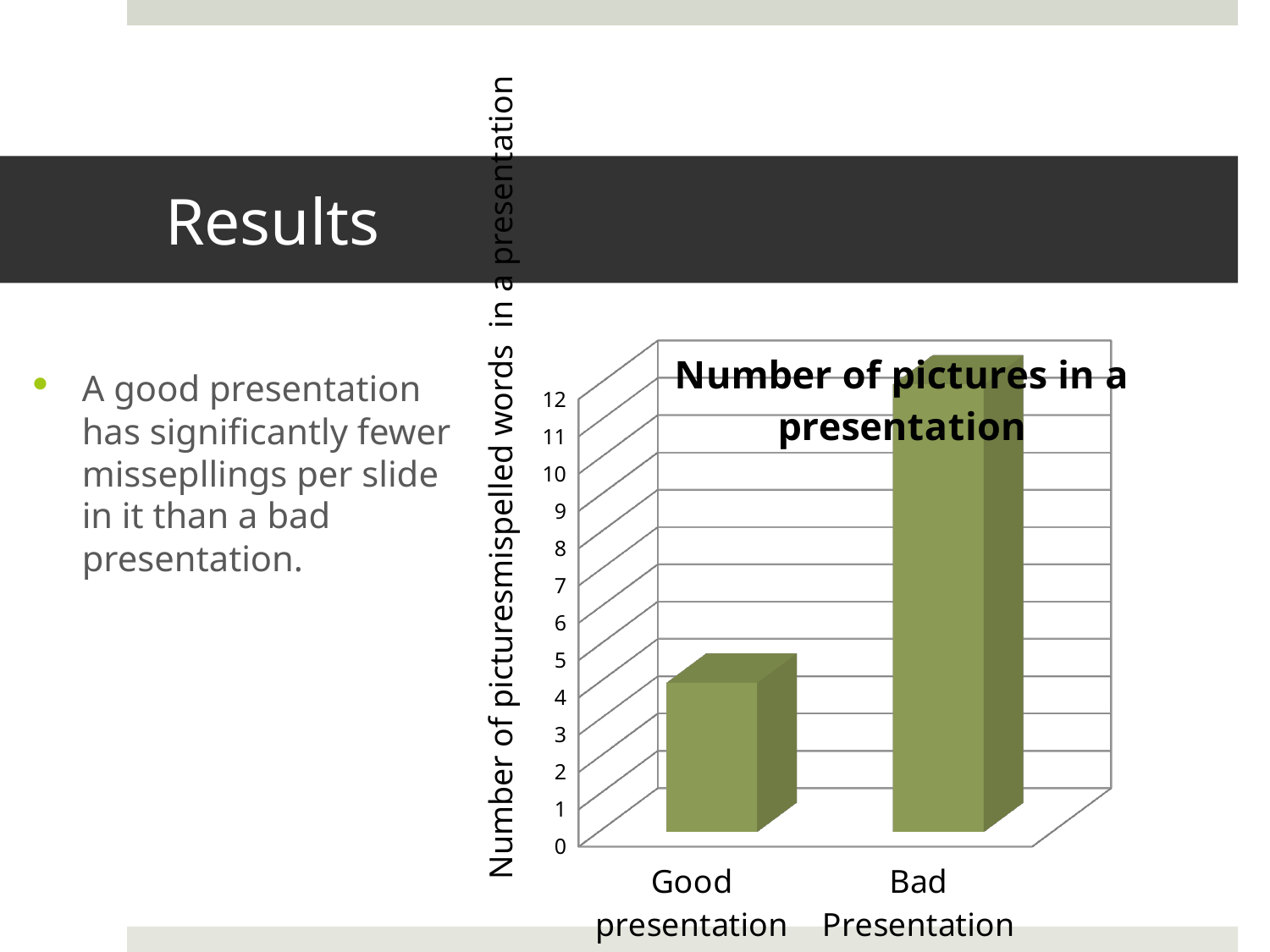
How many categories are plotted in the chart? 2 Is the value for Good presentation greater or less than 2? greater What are the two category labels on the x axis of the chart? Good presentation, Bad Presentation Is the value for Bad Presentation greater or less than 10? greater Which is larger, the value for Good presentation or the value for Bad Presentation? Bad Presentation Which category has the lowest bar? Good presentation What kind of chart is shown on the slide? bar chart What is the title of the chart? Number of pictures in a presentation Is the value for Good presentation greater or less than 8? less Which category has the highest bar? Bad Presentation